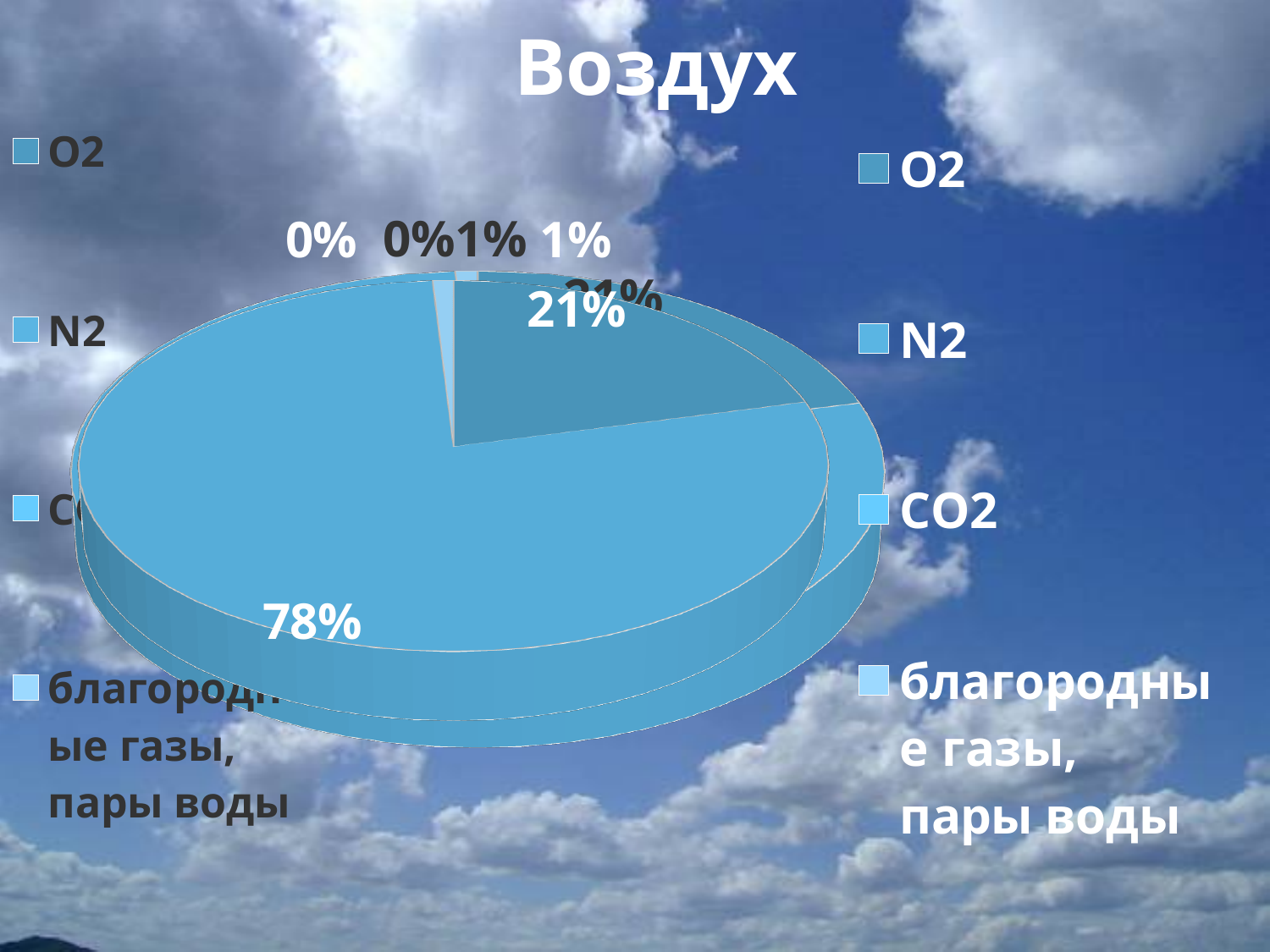
What percentage is shown for CO2? 0% What percentage of the pie does N2 account for? 78% What percentage is shown for благородные газы, пары воды? 1% What percentage of the pie does O2 account for? 21% Which gas has the largest share of the pie? N2 What is the difference between the N2 share and the O2 share? 57% Which legend entry is listed first? O2 Which is larger, the share for N2 or the share for O2? N2 How many entries does the legend list? 4 What kind of chart is shown on the slide? pie chart What is the title of the chart? Воздух